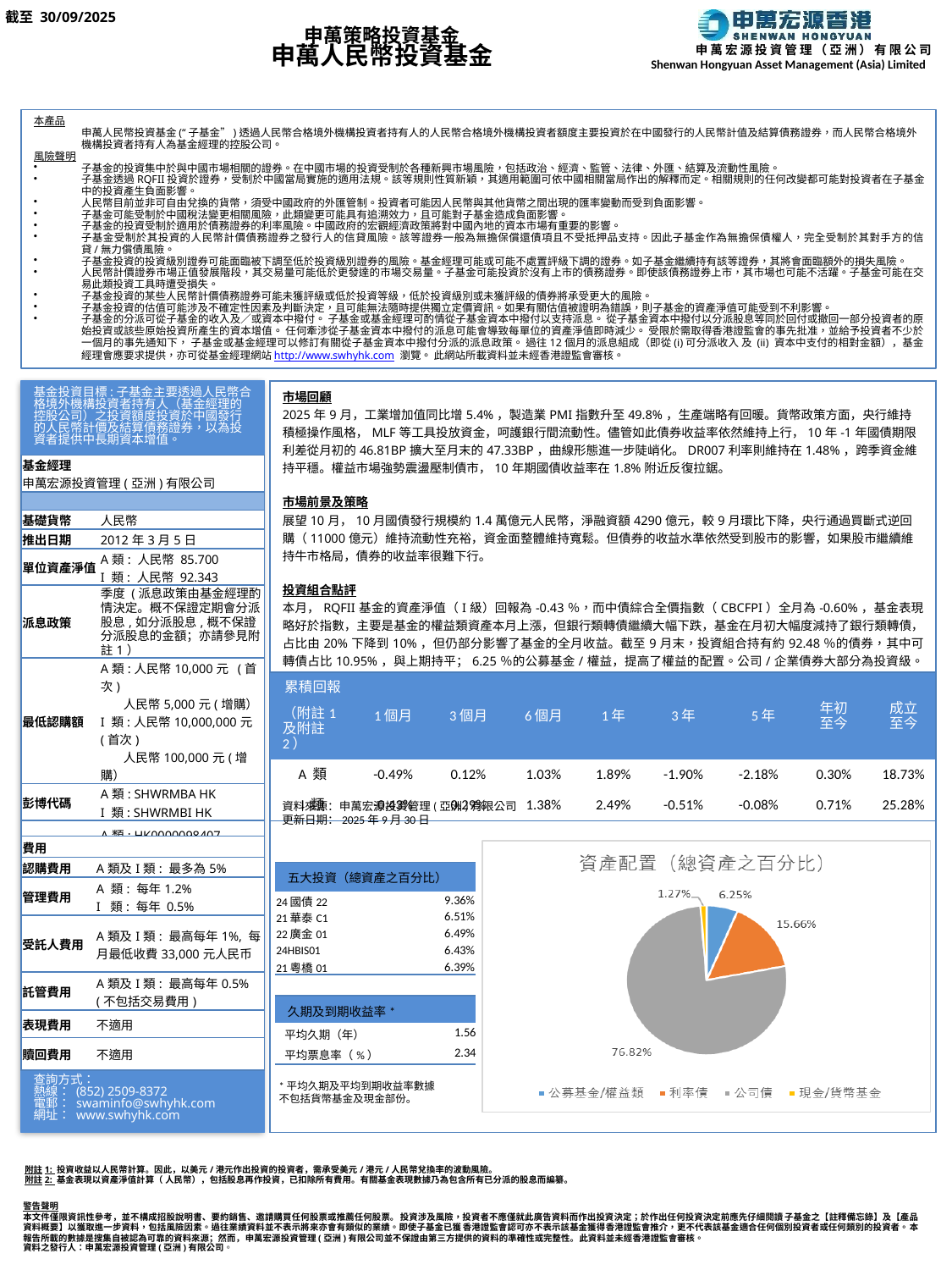
In the 資產配置 pie chart, what is the share for 利率債? 15.66% In the 資產配置 pie chart, what is the share for 公募基金/權益類? 6.25% How many categories does the legend of the 資產配置 pie chart list? 4 In the 資產配置 pie chart, what colour is the slice for 利率債? orange In the 資產配置 pie chart, what is the share for 現金/貨幣基金? 1.27% In the 資產配置 pie chart, what is the difference in percentage points between 公司債 and 利率債? 61.16 In the 資產配置 pie chart, what is the share for 公司債? 76.82% What type of chart is shown under the title 資產配置（總資產之百分比）? pie chart Which category has the smallest slice in the 資產配置 pie chart? 現金/貨幣基金 In the 資產配置 pie chart, which is larger: 利率債 or 公募基金/權益類? 利率債 What is the title of the pie chart on the slide? 資產配置（總資產之百分比） Which category has the largest slice in the 資產配置 pie chart? 公司債